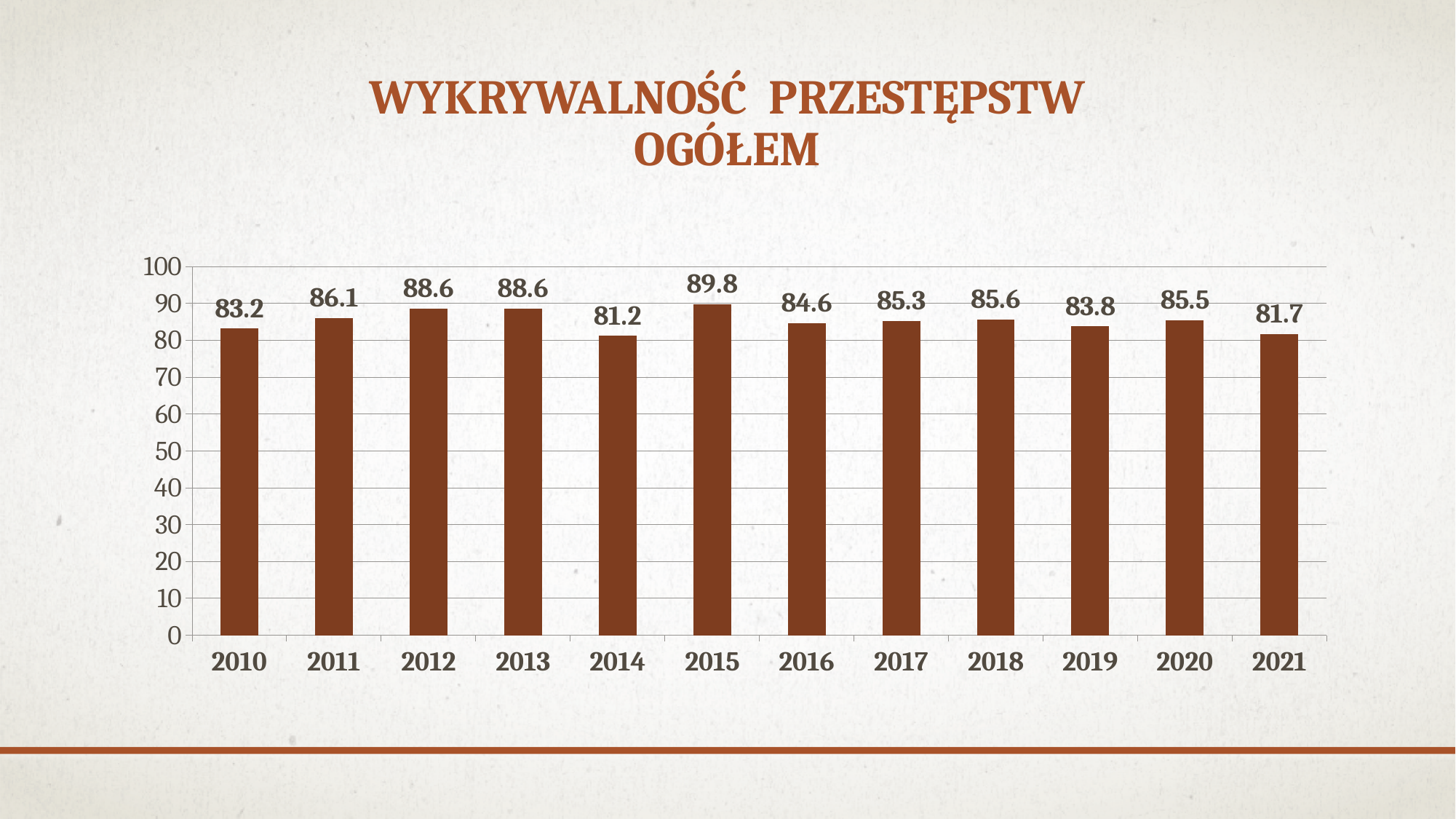
What kind of chart is shown on the slide? bar chart What is the title of the chart? WYKRYWALNOŚĆ PRZESTĘPSTW OGÓŁEM What is the value for 2015? 89.8 What is the value for 2010? 83.2 What is the difference between the values for 2015 and 2014? 8.6 What is the value for 2021? 81.7 Which year has the lowest value? 2014 Which year has the highest value? 2015 Which is larger, the value for 2011 or the value for 2019? 2011 Is the value for 2018 greater or less than 80? greater What is the difference between the values for 2012 and 2010? 5.4 How many years are shown on the x axis? 12